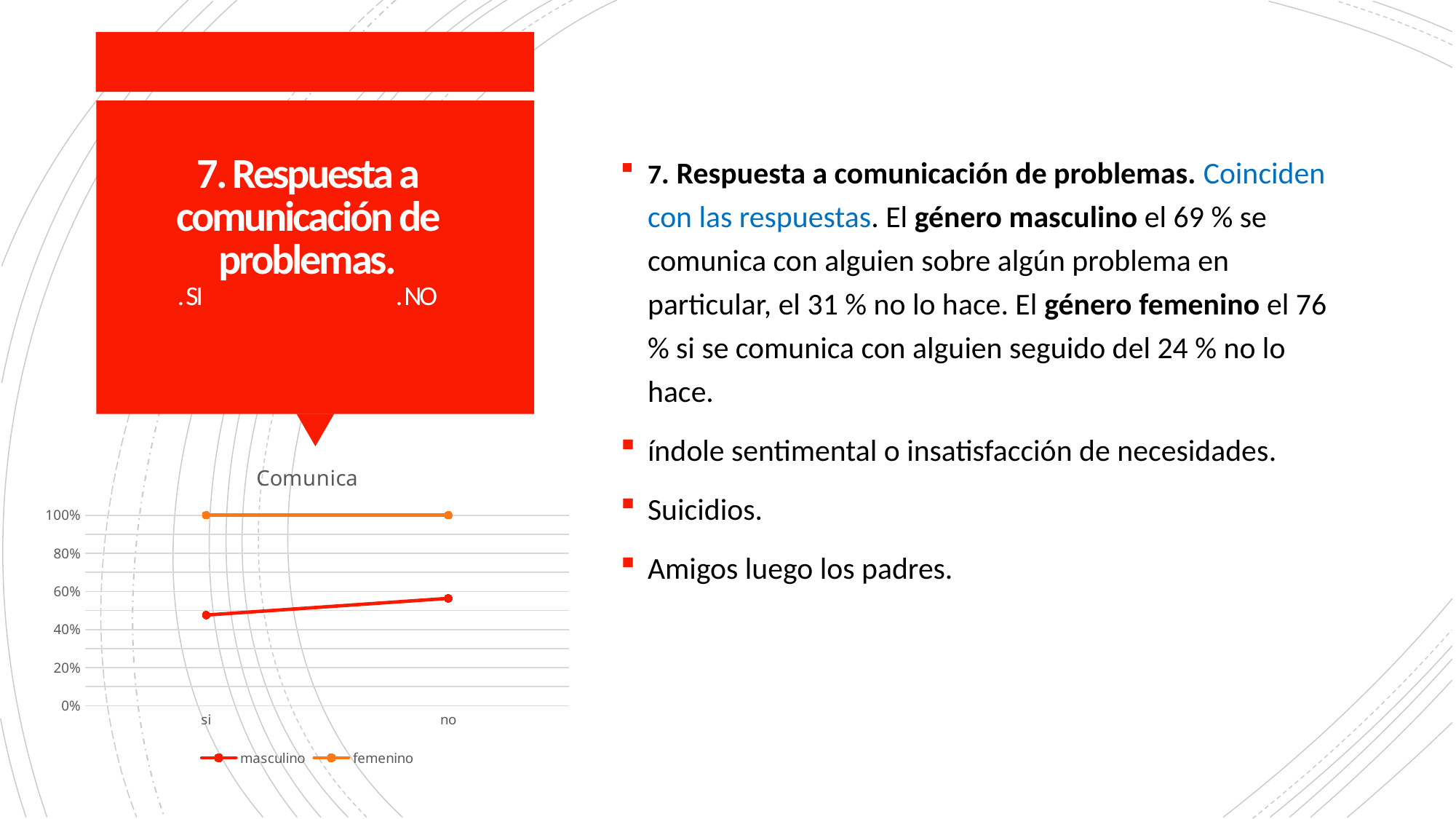
How many categories are shown on the x axis of the chart? 2 Is the value for masculino at "no" greater or less than 40%? greater Is the value for masculino at "si" greater or less than 40%? greater How many series does the chart legend list? 2 What kind of chart is shown on the slide? line chart Is the value for masculino at "si" greater or less than 60%? less What is the title of the chart? Comunica At "si", which series has the larger value, masculino or femenino? femenino Does the masculino line rise or fall from "si" to "no"? rise Which series is drawn in orange in the chart? femenino